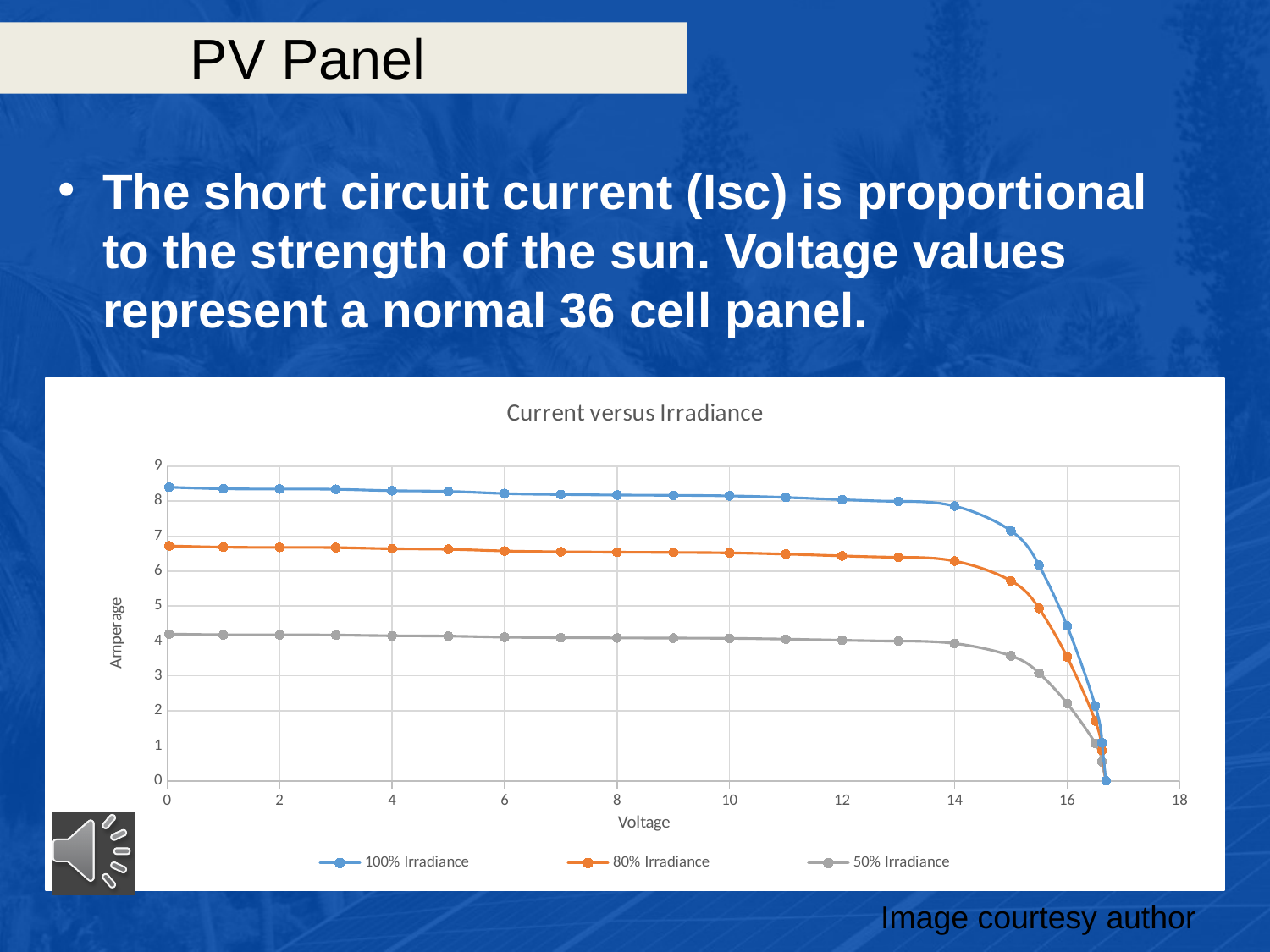
Is the value for 100% Irradiance at a voltage of 0 greater or less than 8? greater What kind of chart is shown on the slide? Line chart Is the value for 100% Irradiance at a voltage of 16 greater or less than 4? greater Which series has the lowest amperage across the voltage range? 50% Irradiance At a voltage of 10, which series has the larger amperage: 100% Irradiance or 50% Irradiance? 100% Irradiance Do the amperage values rise or fall as voltage increases toward 16? fall How many series does the legend list? 3 What is the title of the chart? Current versus Irradiance Is the value for 80% Irradiance at a voltage of 16 greater or less than 4? less What is the label of the vertical axis? Amperage